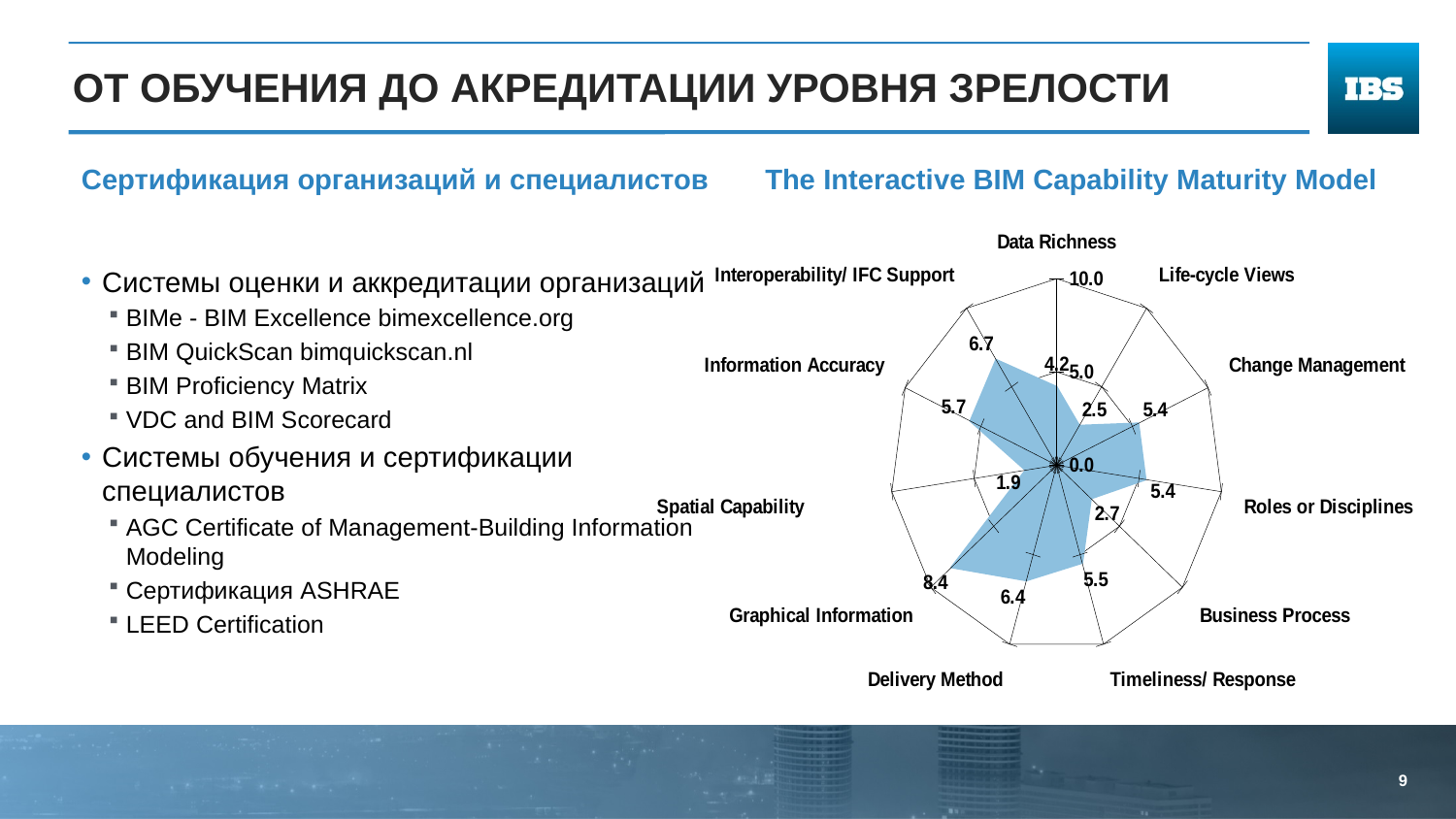
What is the difference between the values for Graphical Information and Spatial Capability? 6.5 What is the maximum value shown on the radar chart's axis scale? 10.0 Which category has the lowest value on the radar chart? Spatial Capability What is the value for Spatial Capability on the radar chart? 1.9 Which is larger on the radar chart: Information Accuracy or Life-cycle Views? Information Accuracy What is the value for Delivery Method on the radar chart? 6.4 Is the value for Timeliness/ Response greater or less than 5.0? greater What kind of chart is shown on the slide? Radar chart How many categories (axes) does the radar chart have? 11 What is the value for Interoperability/ IFC Support on the radar chart? 6.7 What is the value for Graphical Information on the radar chart? 8.4 Which category has the highest value on the radar chart? Graphical Information